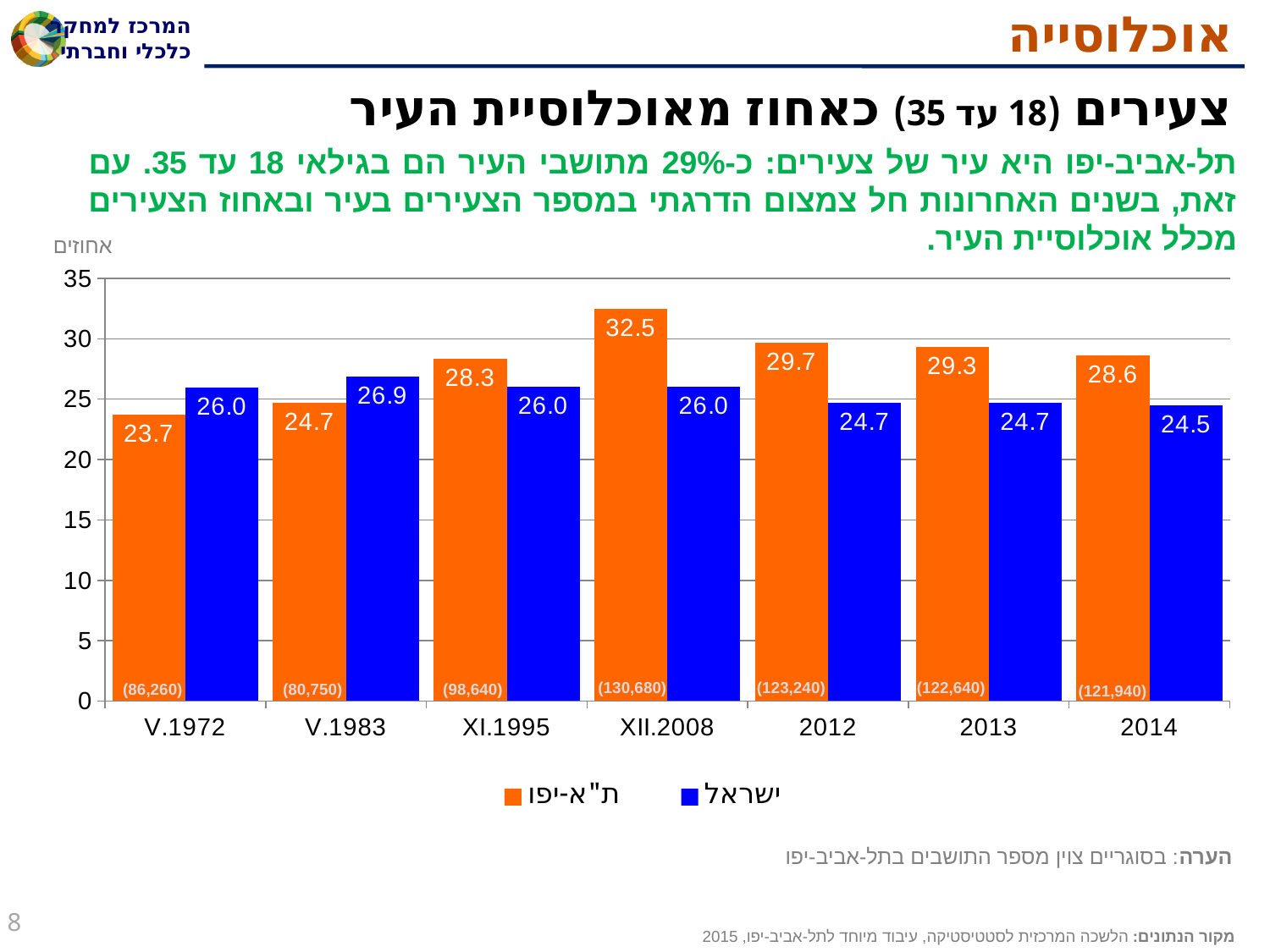
What kind of chart is shown on the slide? bar chart What number is printed in parentheses at the base of the ת"א-יפו bar for XII.2008? (130,680) What is the value for ת"א-יפו in XII.2008? 32.5 What is the value for ישראל in V.1983? 26.9 In which category does ת"א-יפו reach its highest value? XII.2008 How many series does the legend list? 2 In which category is the value for ת"א-יפו the lowest? V.1972 Does the value for ישראל rise or fall from XII.2008 to 2014? fall What is the value for ת"א-יפו in 2014? 28.6 How many categories are shown on the x axis? 7 In V.1972, which series has the larger value, ת"א-יפו or ישראל? ישראל What is the difference between the ת"א-יפו and ישראל values in XII.2008? 6.5